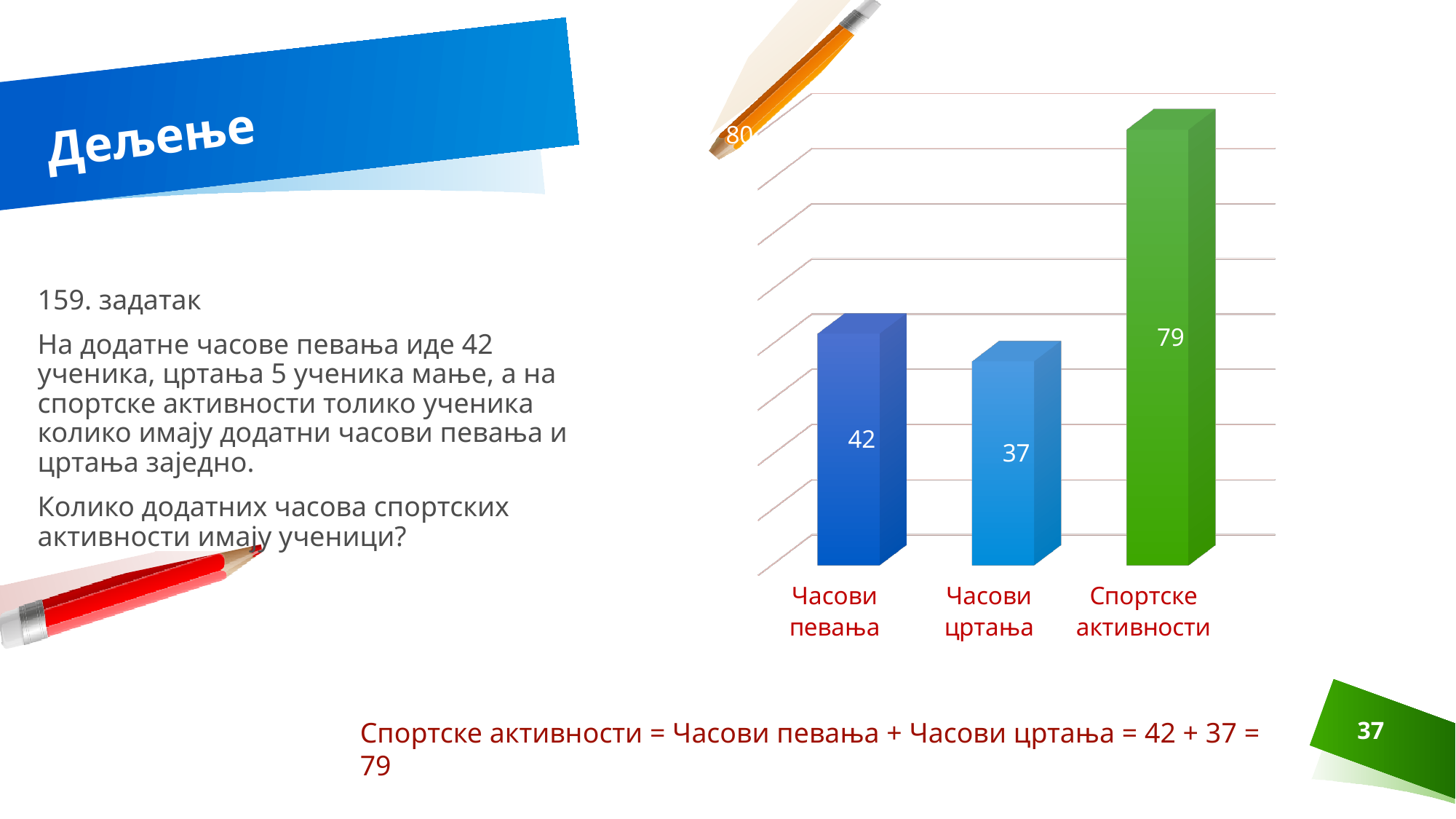
What kind of chart is shown on the slide? bar chart What is the value for Часови цртања? 37 What is the value for Часови певања? 42 Is the value for Спортске активности greater or less than 80? less Which category has the lowest value? Часови цртања What is the value for Спортске активности? 79 What colour is the bar for Спортске активности? green What is the difference between the values for Спортске активности and Часови певања? 37 How many categories are shown in the chart? 3 Which is larger, the value for Часови певања or the value for Часови цртања? Часови певања Which category has the highest value? Спортске активности What is the difference between the values for Часови певања and Часови цртања? 5